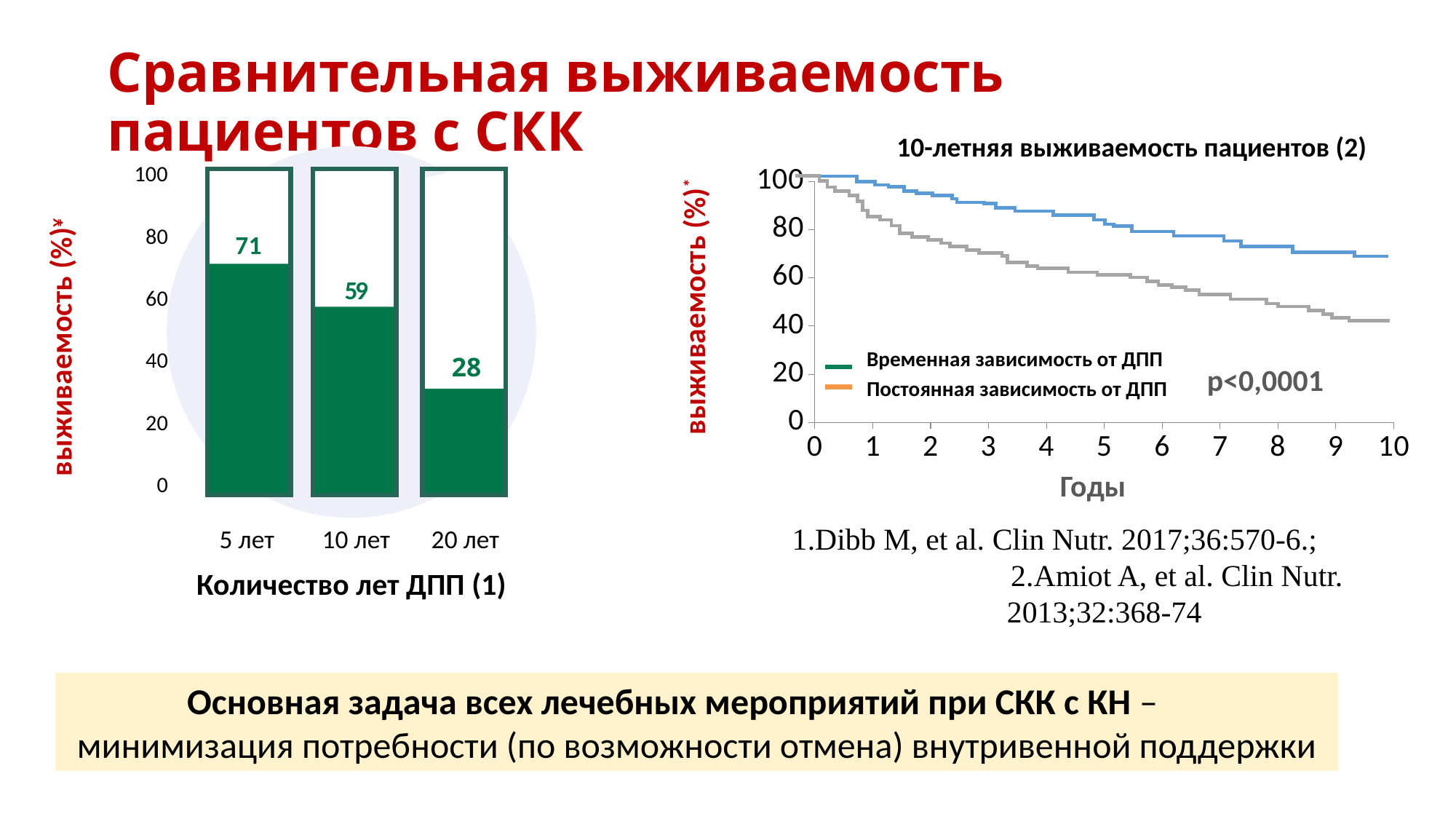
On the left bar chart, what is the difference between the values for 5 лет and 10 лет? 12 On the left bar chart, what is the survival value for 10 лет? 59 What is the x-axis label of the chart titled '10-летняя выживаемость пациентов (2)'? Годы On the left bar chart, how many categories are shown on the x axis? 3 On the chart titled '10-летняя выживаемость пациентов (2)', is the value of the lower (grey) line at year 10 greater or less than 60? less On the left bar chart, do the values rise or fall as the number of years increases? fall On the left bar chart, what is the survival value for 5 лет? 71 On the left bar chart, what is the difference between the values for 5 лет and 20 лет? 43 On the left bar chart, what is the survival value for 20 лет? 28 On the left bar chart, which category has the highest survival value? 5 лет On the left bar chart, which category has the lowest survival value? 20 лет How many series does the legend of the chart titled '10-летняя выживаемость пациентов (2)' list? 2